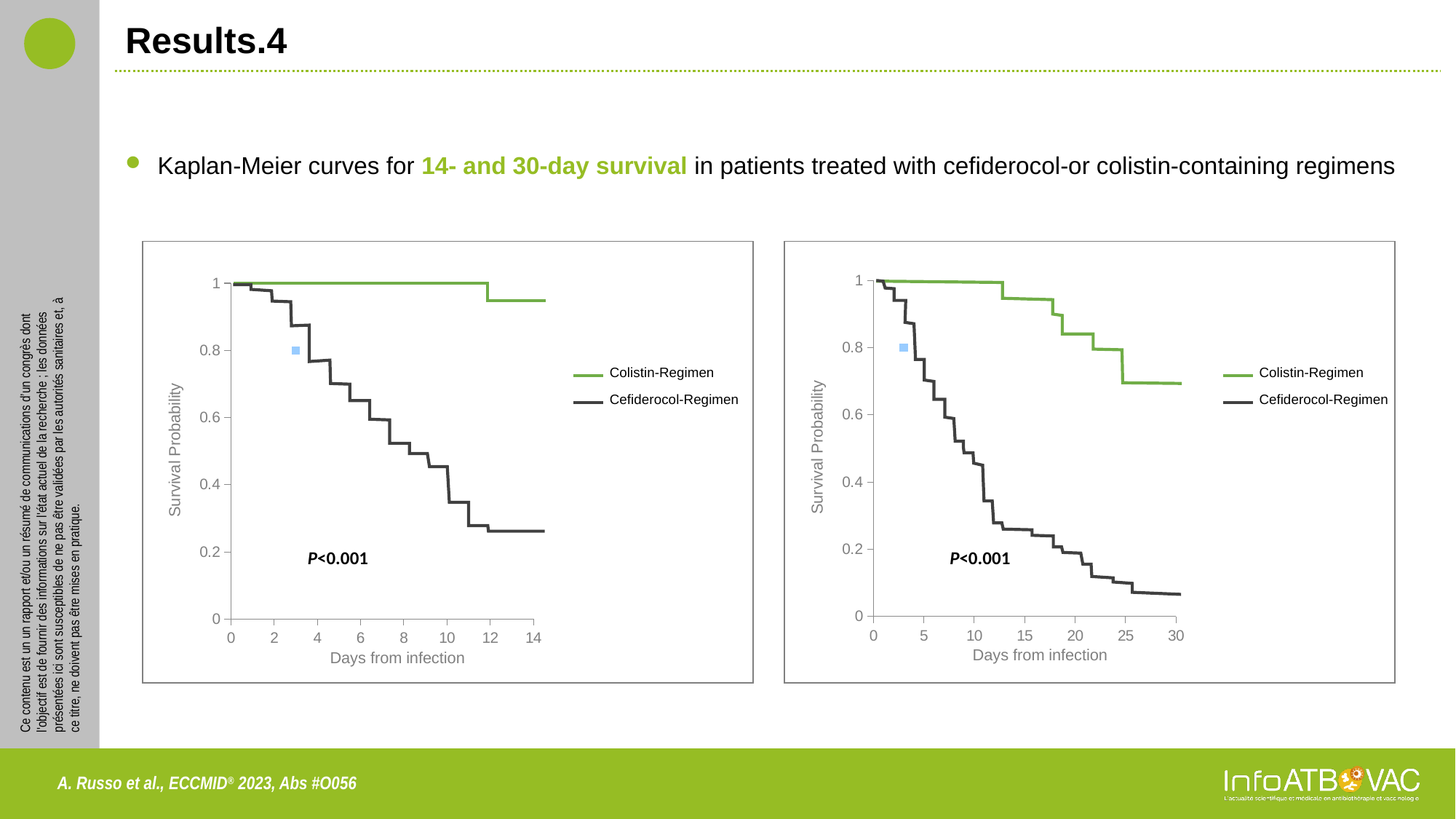
In the left chart (14-day survival), is the survival probability for the Cefiderocol-Regimen at day 14 greater or less than 0.4? less In the right chart (30-day survival), which series is lower at day 30? Cefiderocol-Regimen In the left chart (14-day survival), is the survival probability for the Colistin-Regimen at day 14 greater or less than 0.8? greater In the right chart (30-day survival), is the survival probability for the Colistin-Regimen at day 30 greater or less than 0.8? less What is the x-axis label of the right chart (30-day survival)? Days from infection What kind of chart is the left chart (14-day survival)? Line chart (Kaplan-Meier step curves) What P value is printed on the left chart (14-day survival)? P<0.001 In the right chart (30-day survival), does the Cefiderocol-Regimen curve rise or fall as days from infection increase? Fall In the left chart (14-day survival), which series is higher at day 14? Colistin-Regimen In the left chart (14-day survival), what is the maximum value shown on the x axis? 14 How many series does the legend of the right chart (30-day survival) list? 2